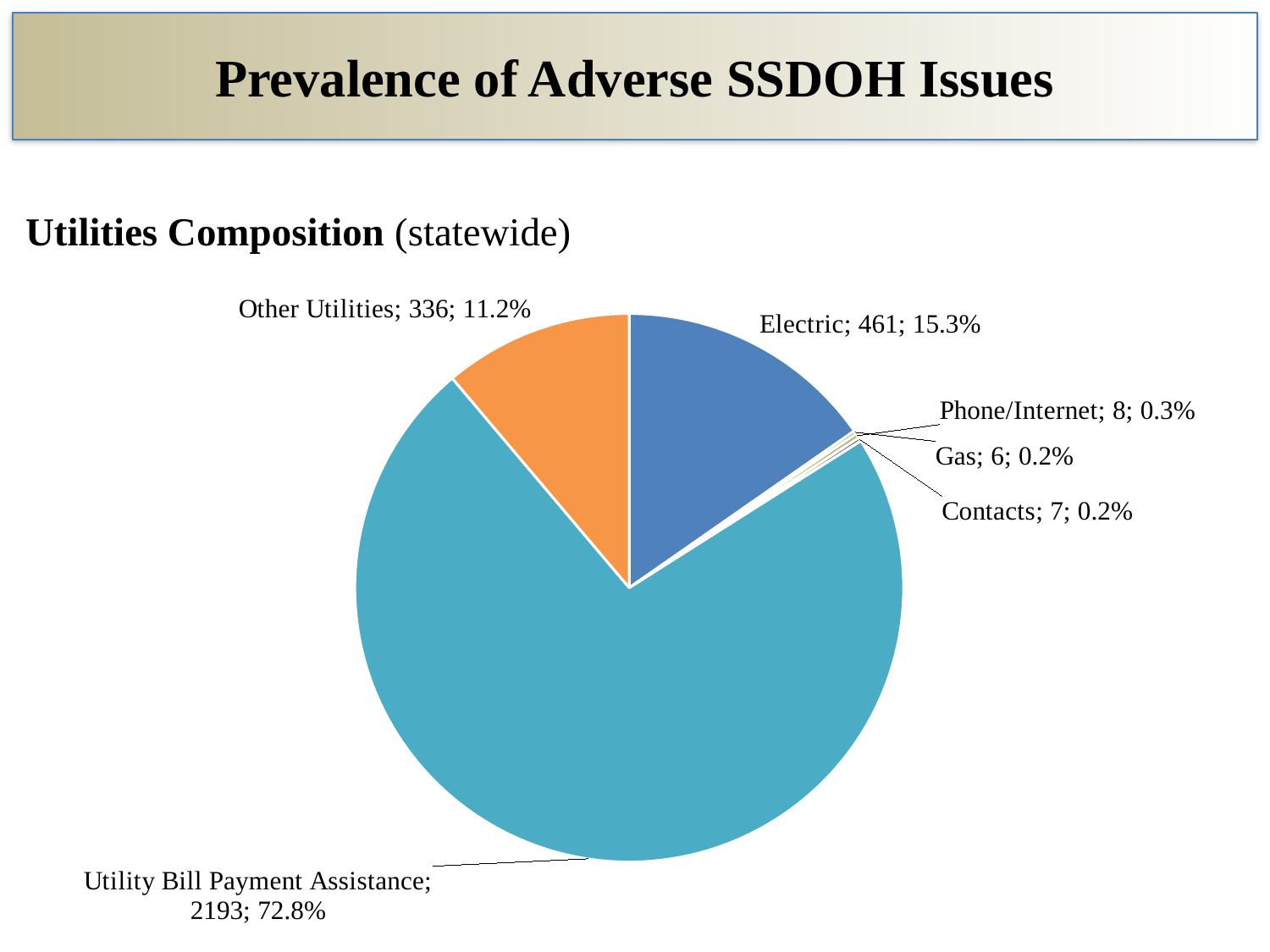
What percentage share does Utility Bill Payment Assistance have? 72.8% What is the count for Electric? 461 How many categories are shown in the pie chart? 6 What kind of chart is shown on the slide? pie chart Which has a larger count, Phone/Internet or Contacts? Phone/Internet What is the count for Utility Bill Payment Assistance? 2193 Which category has the largest slice of the pie? Utility Bill Payment Assistance What is the title of the chart? Utilities Composition (statewide) What is the count for Gas? 6 What is the difference in count between Electric and Other Utilities? 125 What percentage share does Other Utilities have? 11.2% Which category has the smallest count? Gas